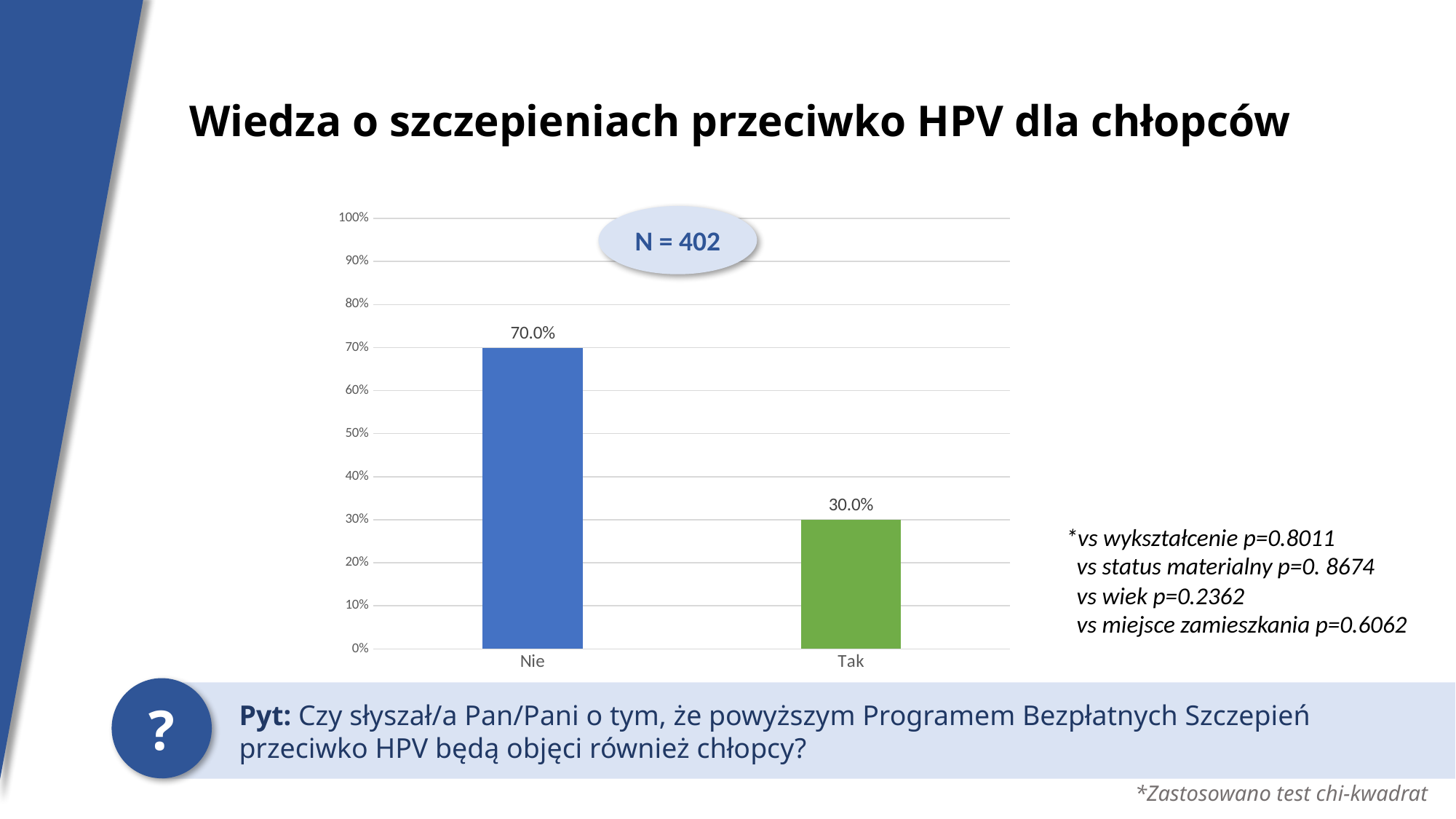
Which category has the lowest value? Tak Is the value for "Tak" greater or less than 50%? less What is the sample size (N) shown on the chart? 402 What is the value for "Tak"? 30.0% What is the difference between the values for "Nie" and "Tak"? 40.0% What kind of chart is shown on the slide? bar chart What is the value for "Nie"? 70.0% Which category has the highest value? Nie Which is larger, the value for "Nie" or the value for "Tak"? Nie How many categories are shown on the x axis? 2 What colour is the bar for "Tak"? green What is the maximum value shown on the y axis? 100%